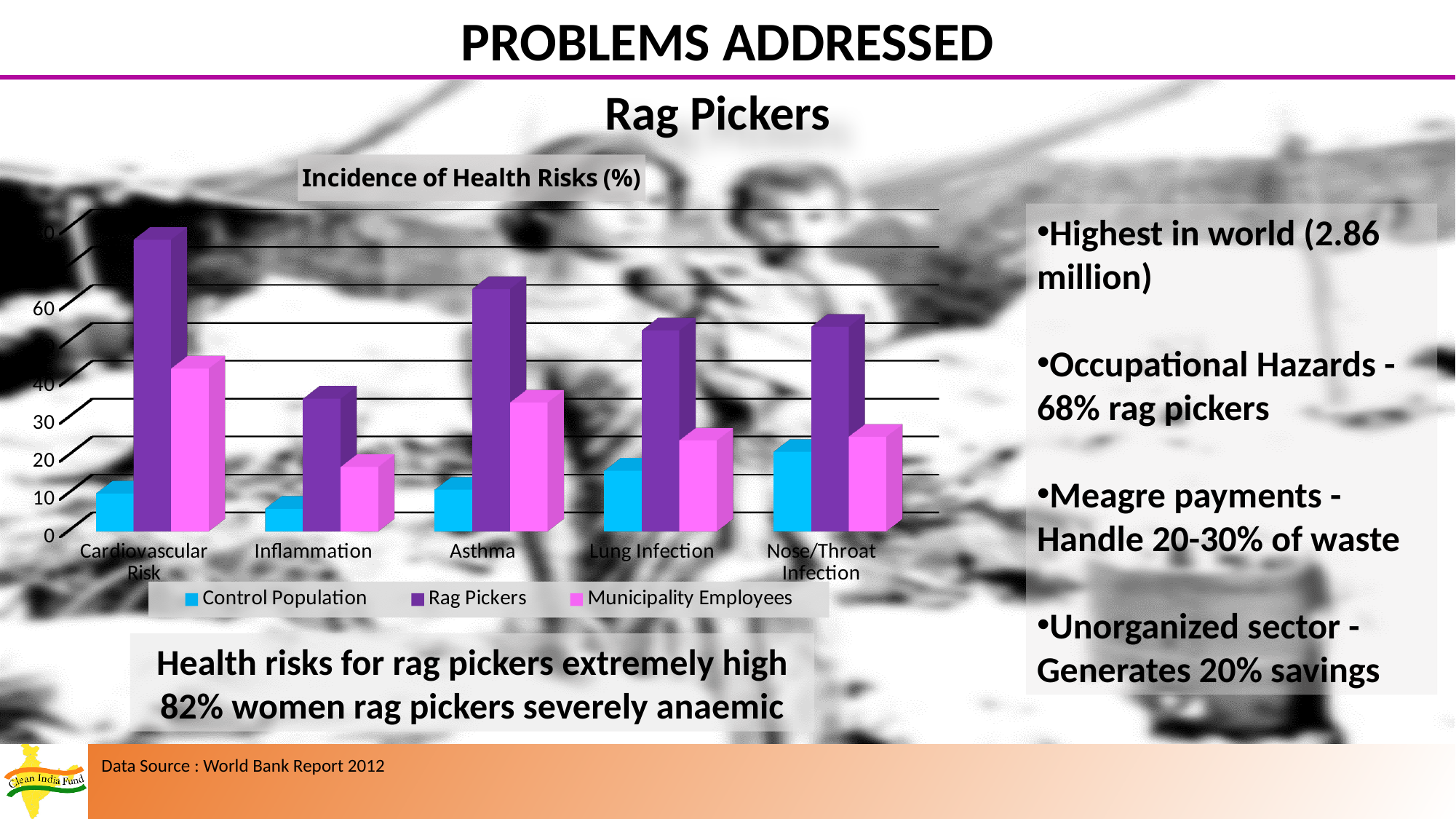
How many series does the chart's legend list? 3 Is the Rag Pickers value for Cardiovascular Risk greater or less than 60? greater For Asthma, which series has the larger value: Rag Pickers or Municipality Employees? Rag Pickers Which colour represents the Rag Pickers series in the chart? Purple What kind of chart is shown on the slide? Bar chart Is the Municipality Employees value for Cardiovascular Risk greater or less than 30? greater For which category is the Rag Pickers value lowest? Inflammation For which category is the Rag Pickers value highest? Cardiovascular Risk Is the Control Population value for Cardiovascular Risk greater or less than 20? less For which category is the Control Population value lowest? Inflammation How many health risk categories are shown on the x axis? 5 What is the title of the chart? Incidence of Health Risks (%)